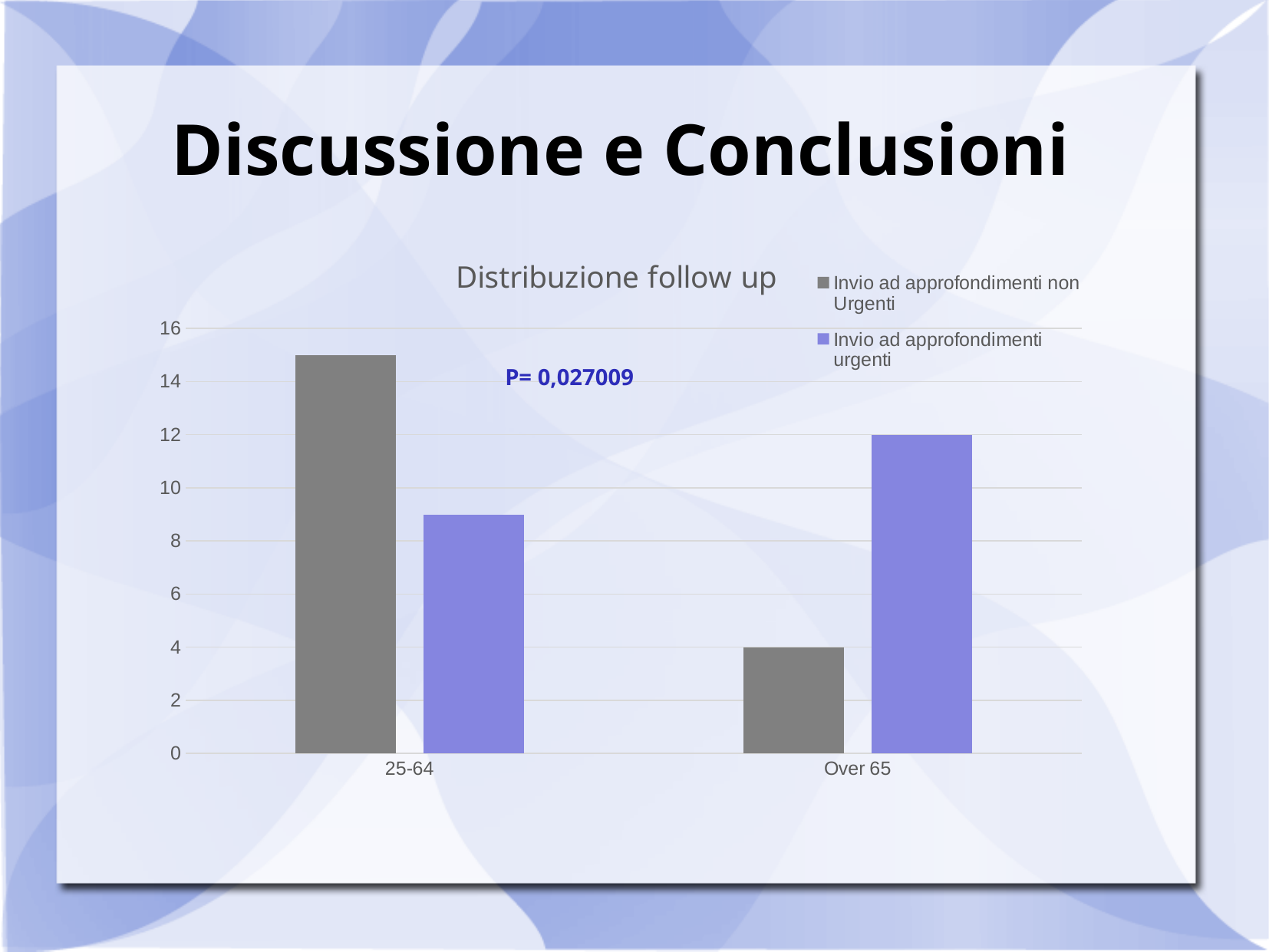
Which bar is the tallest in the chart? Invio ad approfondimenti non Urgenti, 25-64 Is the value for 'Invio ad approfondimenti urgenti' in the 25-64 category greater or less than 10? less What type of chart is shown on the slide? bar chart What is the difference between the urgenti and non Urgenti values in the Over 65 category? 8 How many categories are shown on the x axis? 2 What is the value for 'Invio ad approfondimenti non Urgenti' in the Over 65 category? 4 What is the value for 'Invio ad approfondimenti urgenti' in the Over 65 category? 12 Which category has the higher value for 'Invio ad approfondimenti non Urgenti', 25-64 or Over 65? 25-64 Is the value for 'Invio ad approfondimenti non Urgenti' in the 25-64 category greater or less than 14? greater What P value is printed on the chart? P= 0,027009 What is the title of the chart? Distribuzione follow up How many series does the legend list? 2